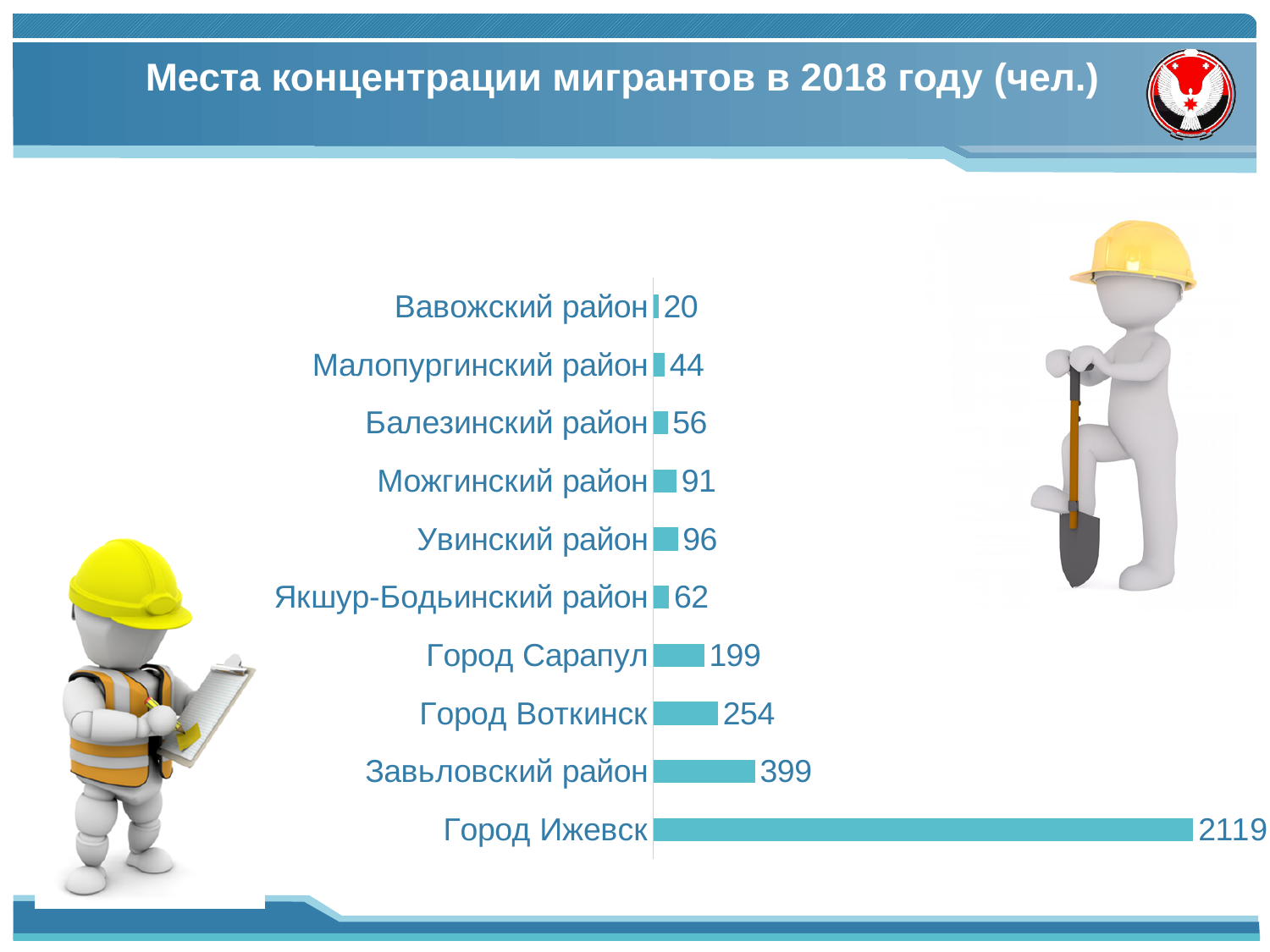
What kind of chart is shown on the slide? bar chart What is the value for Город Ижевск? 2119 What is the difference between the values for Завьяловский район and Город Воткинск? 145 What is the title of the slide? Места концентрации мигрантов в 2018 году (чел.) What is the value for Город Воткинск? 254 Which is larger, the value for Можгинский район or the value for Якшур-Бодьинский район? Можгинский район Which category has the highest value? Город Ижевск What is the difference between the values for Город Сарапул and Малопургинский район? 155 What is the value for Увинский район? 96 How many categories are shown in the chart? 10 What is the value for Завьяловский район? 399 Which category has the lowest value? Вавожский район